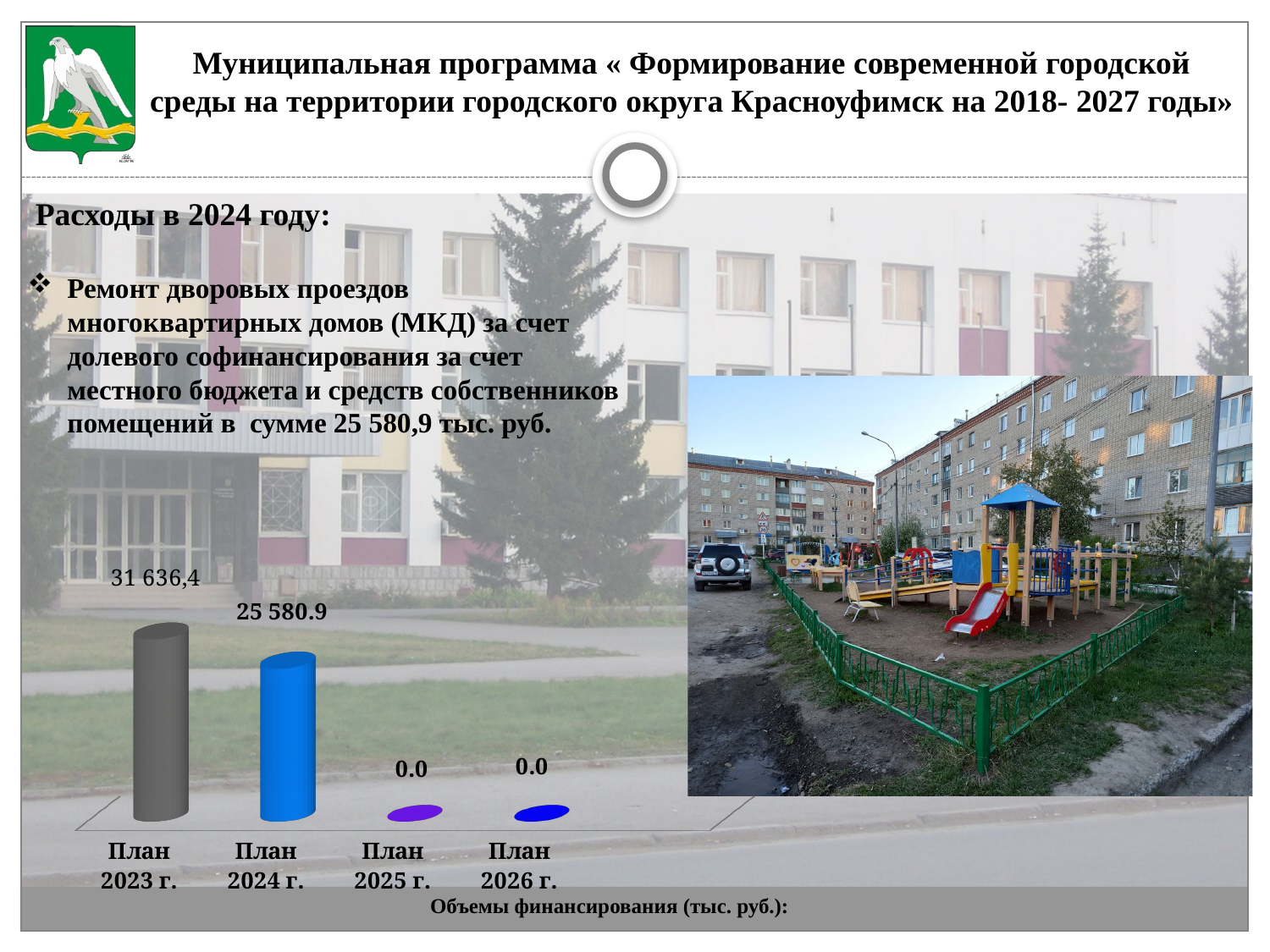
What is the value for План 2023 г.? 31 636,4 How many categories are shown in the chart? 4 What is the value for План 2025 г.? 0.0 What kind of chart is shown on the slide? Bar chart Which is larger, the value for План 2023 г. or the value for План 2024 г.? План 2023 г. What colour is the bar for План 2024 г.? Blue What is the difference between the values for План 2023 г. and План 2024 г.? 6 055,5 What is the value for План 2026 г.? 0.0 Do the values rise or fall from План 2023 г. to План 2026 г.? Fall Which category has the highest value? План 2023 г. What is the value for План 2024 г.? 25 580.9 What is the title shown below the chart? Объемы финансирования (тыс. руб.):